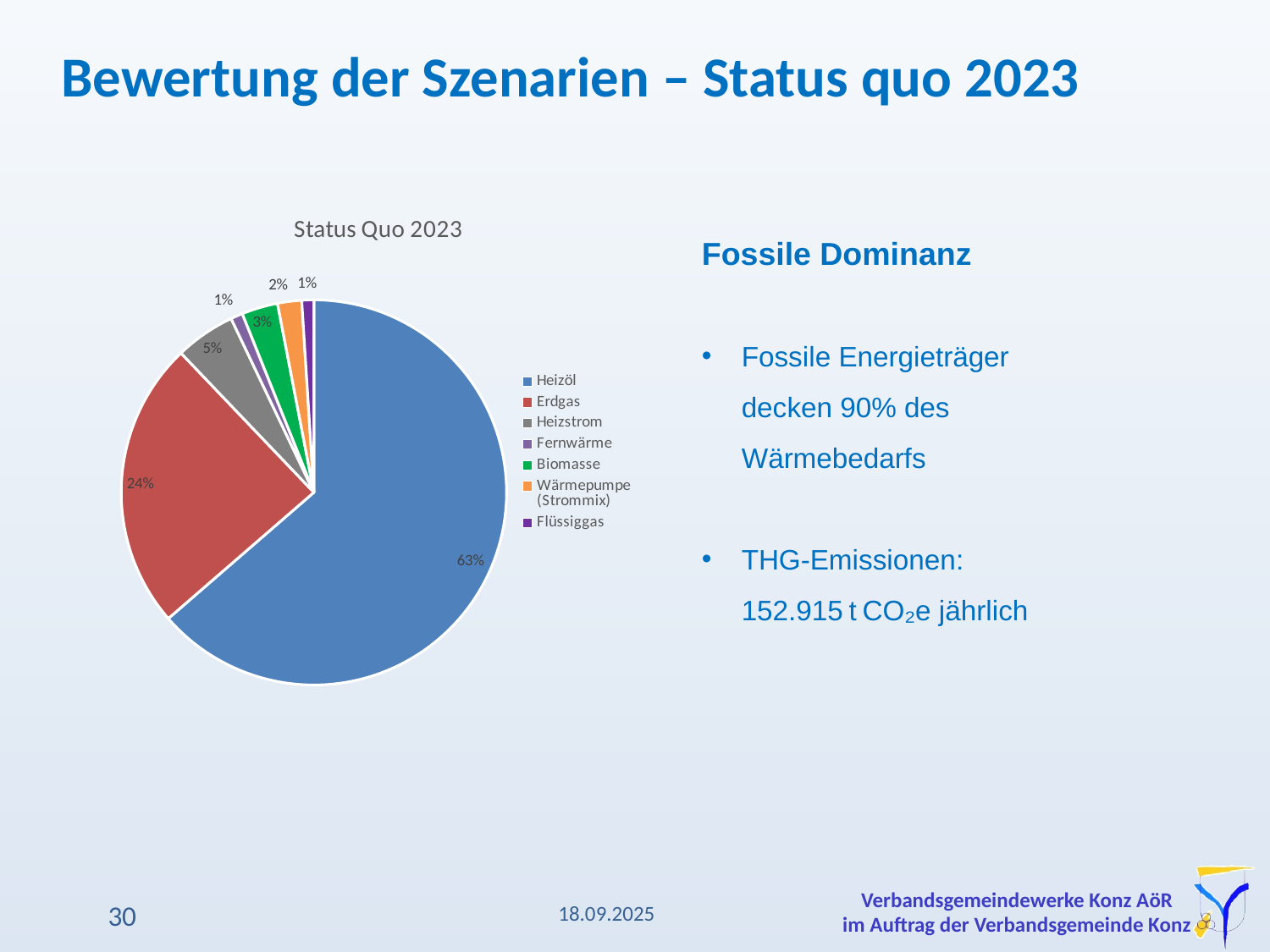
What share of the pie does Wärmepumpe (Strommix) have? 2% What share of the pie does Erdgas have? 24% What share of the pie does Heizstrom have? 5% What is the title of the chart? Status Quo 2023 What is the difference in percentage points between the Heizöl share and the Erdgas share? 39 percentage points Which category has the largest slice of the pie? Heizöl How many slices does the pie chart have? 7 What colour is the Biomasse slice in the pie chart? green What type of chart is shown on the slide? pie chart Which is larger, the share for Erdgas or the share for Heizstrom? Erdgas